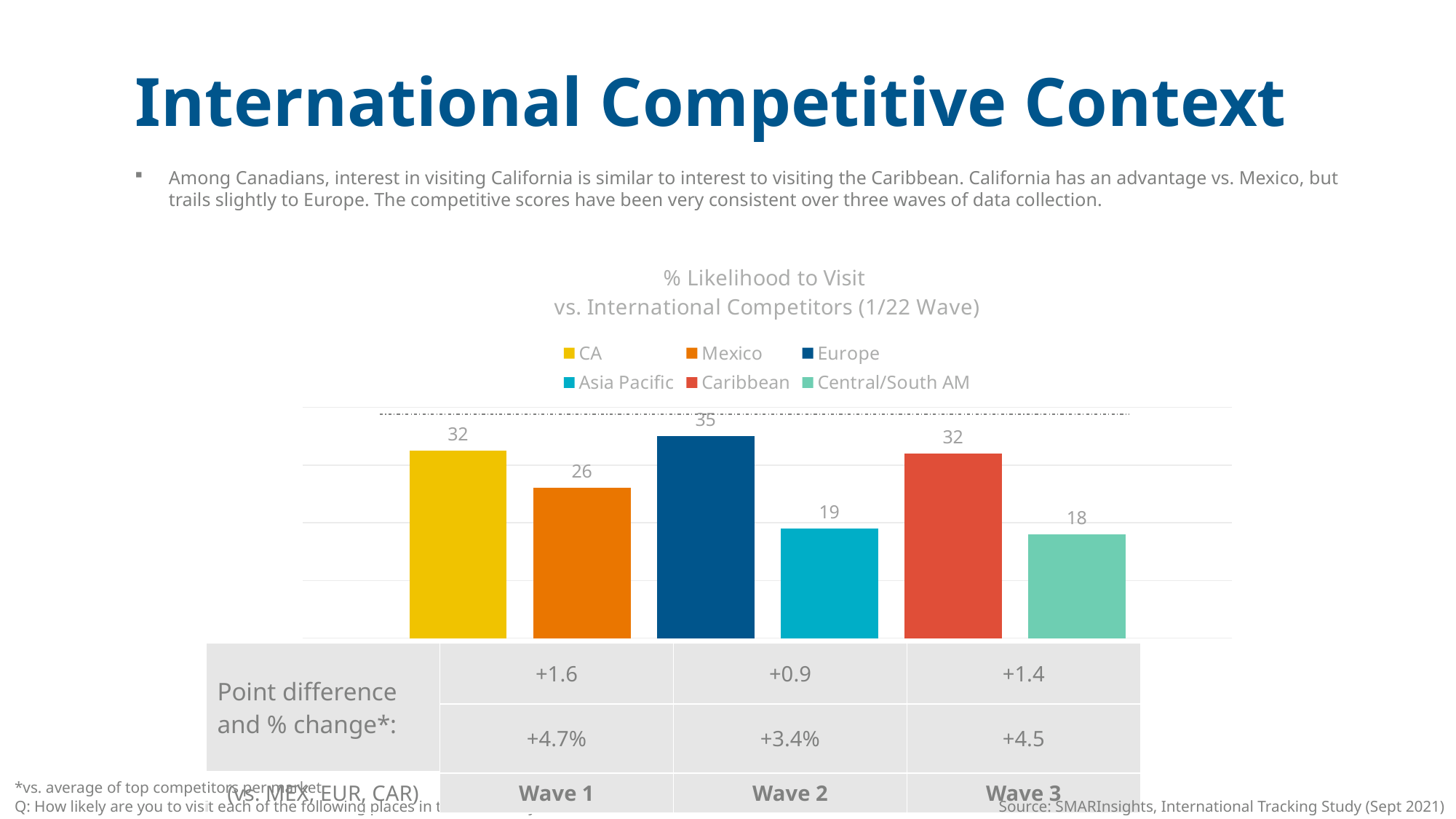
Which has a larger % likelihood to visit, CA or Mexico? CA What type of chart is shown on the slide? bar chart What is the % likelihood to visit value for Europe? 35 What is the % likelihood to visit value for Mexico? 26 Which destination has the highest % likelihood to visit? Europe How many series does the chart legend list? 6 What is the % likelihood to visit value for Asia Pacific? 19 What is the % likelihood to visit value for Central/South AM? 18 What is the % likelihood to visit value for CA? 32 What is the title of the chart? % Likelihood to Visit vs. International Competitors (1/22 Wave) What is the difference between the values for Europe and CA? 3 Which destination has the lowest % likelihood to visit? Central/South AM